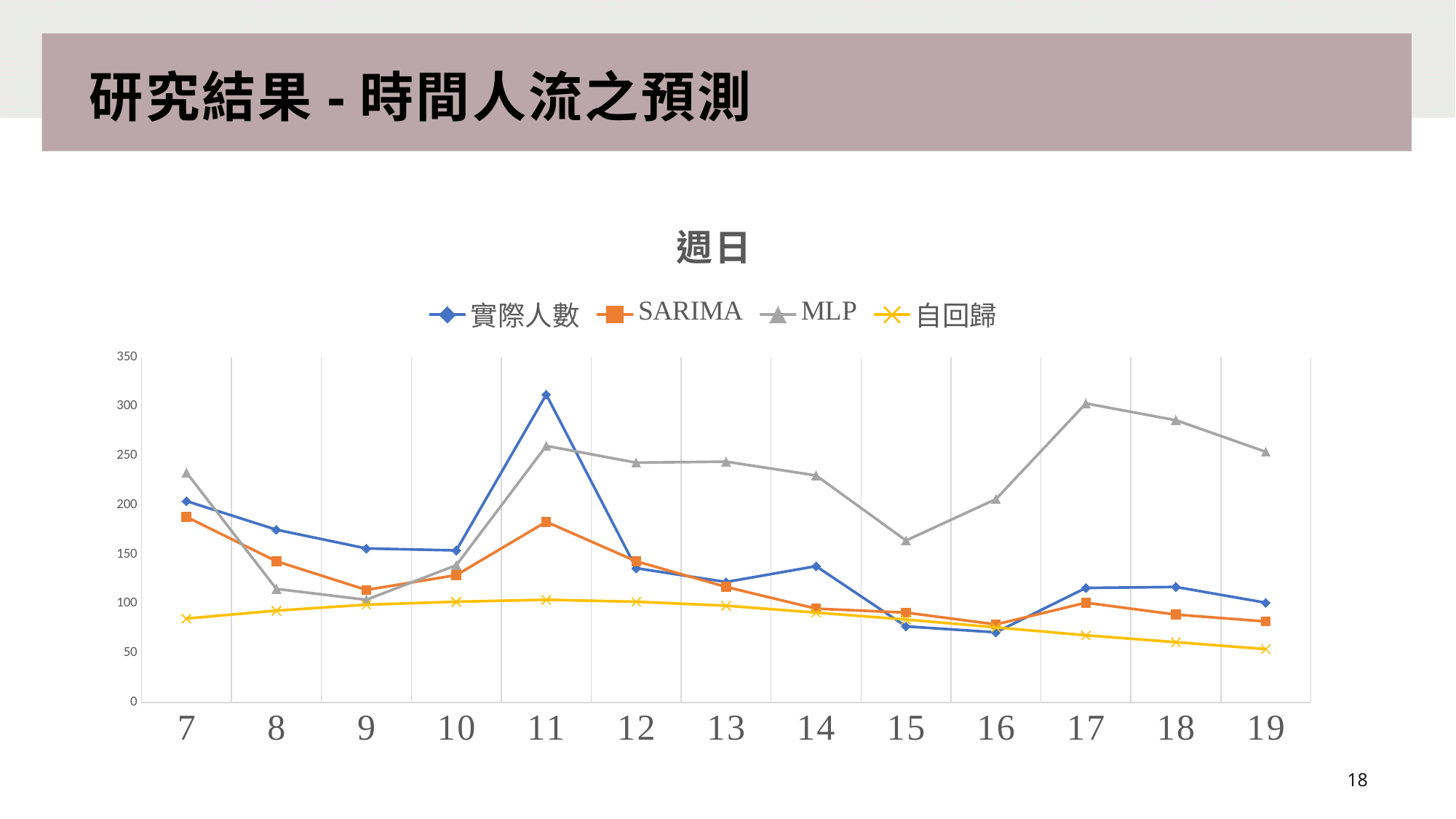
At which hour does the 自回歸 series reach its lowest value? 19 Does the 自回歸 series rise or fall from hour 11 to hour 19? fall How many points are there along the x axis? 13 How many series does the legend list? 4 At which hour does the 實際人數 series reach its highest value? 11 At hour 8, which series has the larger value, 實際人數 or MLP? 實際人數 Is the value of 實際人數 at hour 11 greater or less than 300? greater Is the value of 自回歸 at hour 19 greater or less than 100? less What kind of chart is shown on the slide? line chart At hour 17, which series has the larger value, MLP or 實際人數? MLP What is the title of the chart? 週日 Is the value of SARIMA at hour 7 greater or less than 150? greater